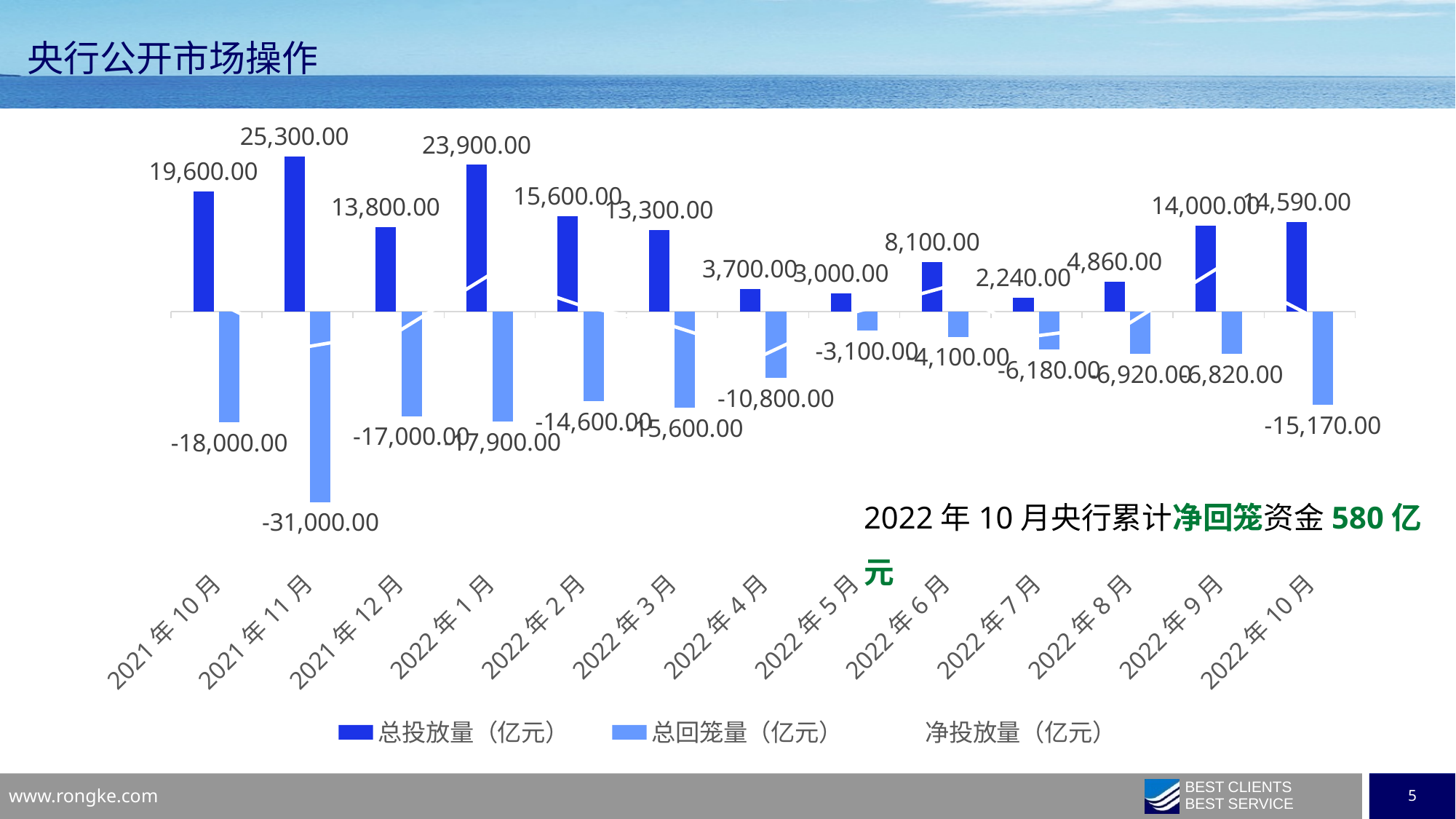
What is the title of the slide containing the chart? 央行公开市场操作 Which month has the highest 总投放量（亿元）? 2021年11月 Which month has the lowest 总投放量（亿元）? 2022年7月 How many months (categories) are shown on the x axis of the chart? 13 What is the 总回笼量（亿元） value for 2022年4月? -10,800.00 By how much does the 总投放量（亿元） for 2021年11月 exceed that for 2021年10月? 5,700.00 How many series does the chart legend list? 3 What is the 总投放量（亿元） value for 2022年10月? 14,590.00 What is the 总回笼量（亿元） value for 2021年11月? -31,000.00 What kind of chart is shown on the slide? Bar chart What is the 总投放量（亿元） value for 2021年11月? 25,300.00 Which month has the larger 总投放量（亿元）, 2022年1月 or 2022年2月? 2022年1月